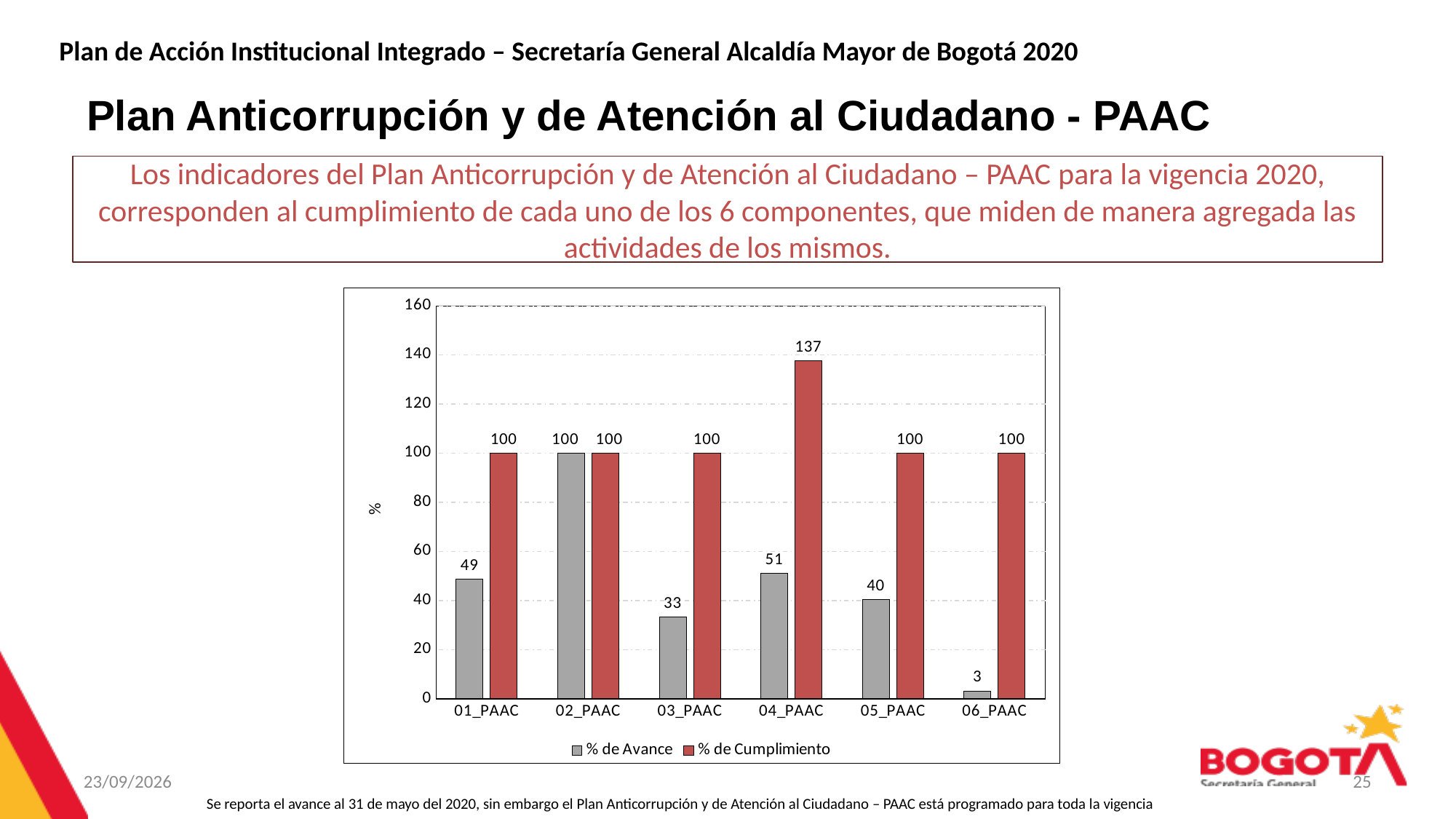
What kind of chart is shown on the slide? Bar chart Which category has the lowest % de Avance? 06_PAAC How many series does the legend list? 2 Which is larger for 05_PAAC: % de Avance or % de Cumplimiento? % de Cumplimiento How many categories are shown on the x axis? 6 Which category has the highest % de Avance? 02_PAAC What is the % de Avance value for 01_PAAC? 49 What is the % de Cumplimiento value for 04_PAAC? 137 What is the difference between % de Cumplimiento and % de Avance for 03_PAAC? 67 Which category has the highest % de Cumplimiento? 04_PAAC What is the % de Avance value for 06_PAAC? 3 What label is shown on the vertical axis? %